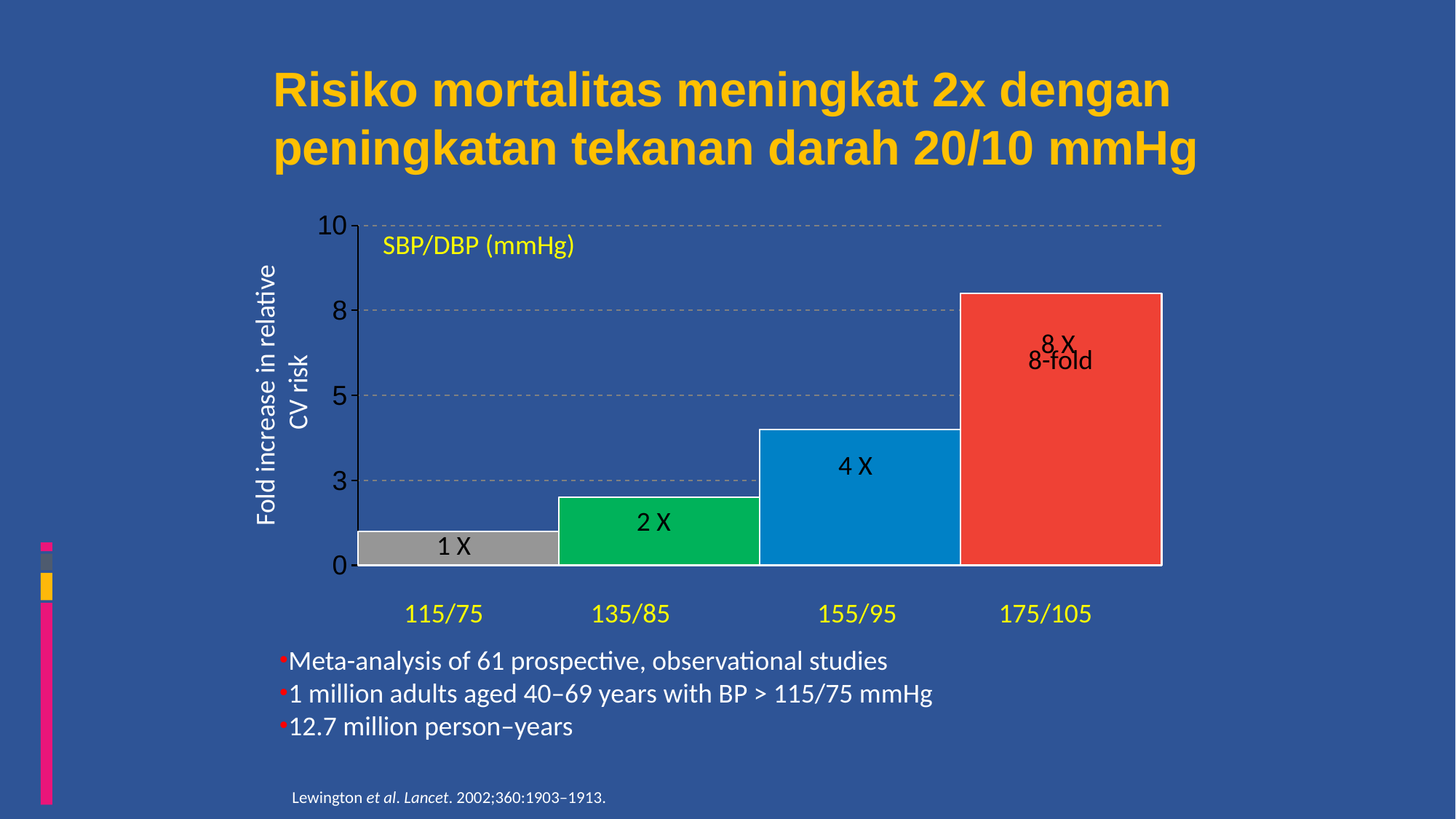
How many SBP/DBP categories are shown on the x axis? 4 What kind of chart is shown on the slide? Bar chart What is the data label on the bar for 175/105? 8 X Which SBP/DBP category has the highest fold increase in relative CV risk? 175/105 What is the data label on the bar for 135/85? 2 X Which has a larger fold increase in relative CV risk, 135/85 or 155/95? 155/95 What is the data label on the bar for 155/95? 4 X What is the data label on the bar for 115/75? 1 X Which SBP/DBP category has the lowest fold increase in relative CV risk? 115/75 What is the title of the y axis? Fold increase in relative CV risk Do the bar values rise or fall as SBP/DBP increases along the x axis? Rise